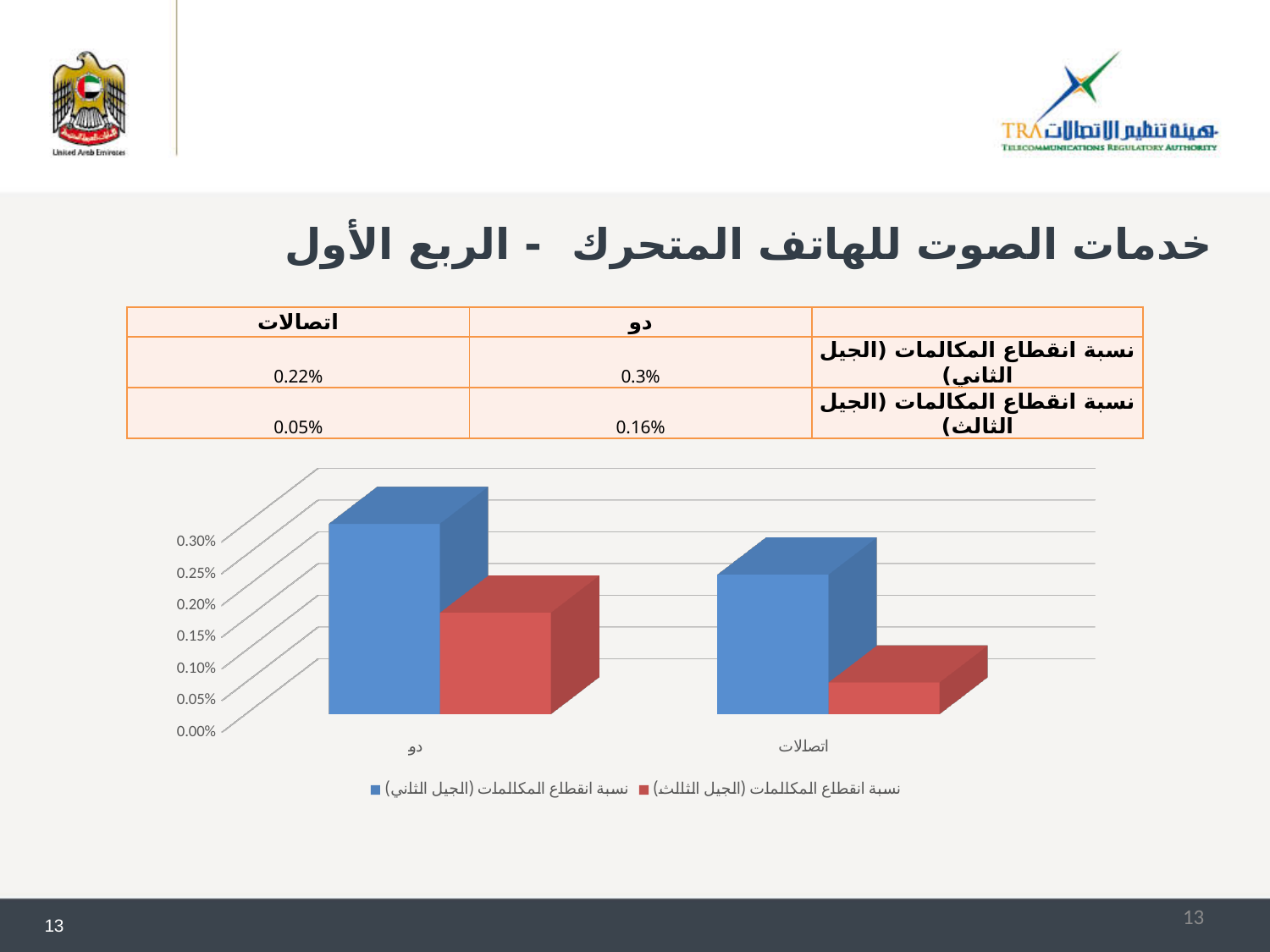
Which operator has the higher second generation (الجيل الثاني) call drop rate? دو What is the call drop rate for the second generation (الجيل الثاني) for دو? 0.3% What is the difference between the second generation call drop rates of دو and اتصالات? 0.08% What is the call drop rate for the third generation (الجيل الثالث) for اتصالات? 0.05% Which colour represents the second generation (الجيل الثاني) series in the chart? Blue How many series does the chart legend list? 2 Which operator has the lower third generation (الجيل الثالث) call drop rate? اتصالات What is the call drop rate for the second generation (الجيل الثاني) for اتصالات? 0.22% What is the call drop rate for the third generation (الجيل الثالث) for دو? 0.16% Is the second generation (الجيل الثاني) call drop rate for اتصالات greater or less than 0.20%? greater What kind of chart is shown on the slide? Bar chart How many categories (operators) are shown on the x axis of the chart? 2